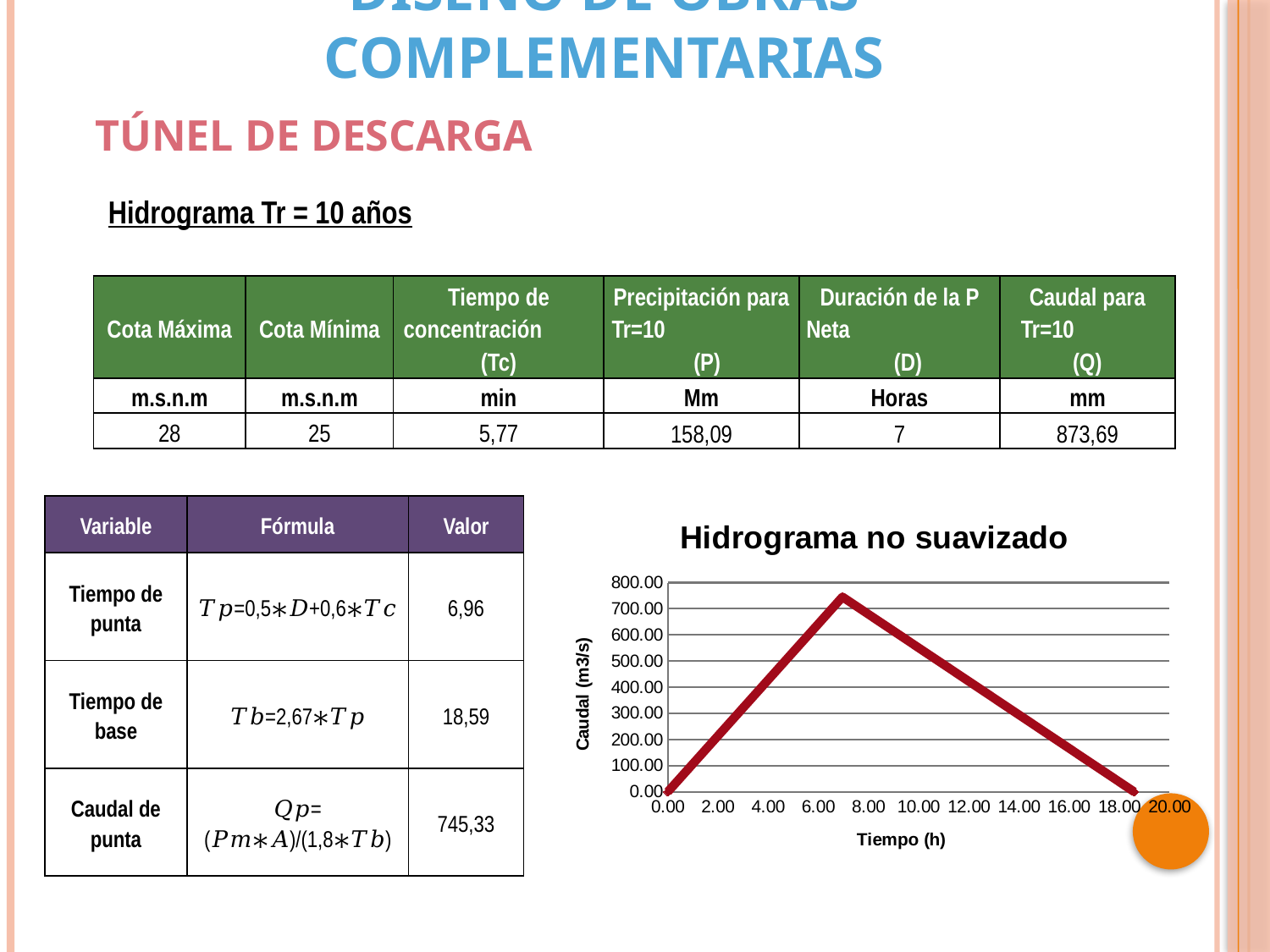
How many data points make up the line in the 'Hidrograma no suavizado' chart? 3 In the 'Hidrograma no suavizado' chart, is the peak value of the line greater or less than 800.00? less In the 'Hidrograma no suavizado' chart, what is the Caudal value at Tiempo 0.00? 0.00 In the 'Hidrograma no suavizado' chart, is the Tiempo at which the line returns to 0.00 greater or less than 18.00? greater In the 'Hidrograma no suavizado' chart, is the peak value of the line greater or less than 700.00? greater In the 'Hidrograma no suavizado' chart, which is larger: the Caudal value at Tiempo 0.00 or the Caudal value at the peak? the peak What is the label of the y axis of the 'Hidrograma no suavizado' chart? Caudal (m3/s) In the 'Hidrograma no suavizado' chart, does the line rise or fall after the peak toward Tiempo 18.00? fall What type of chart is 'Hidrograma no suavizado'? line chart In the 'Hidrograma no suavizado' chart, does the line rise or fall between Tiempo 0.00 and the peak? rise What is the title of the chart on the slide? Hidrograma no suavizado